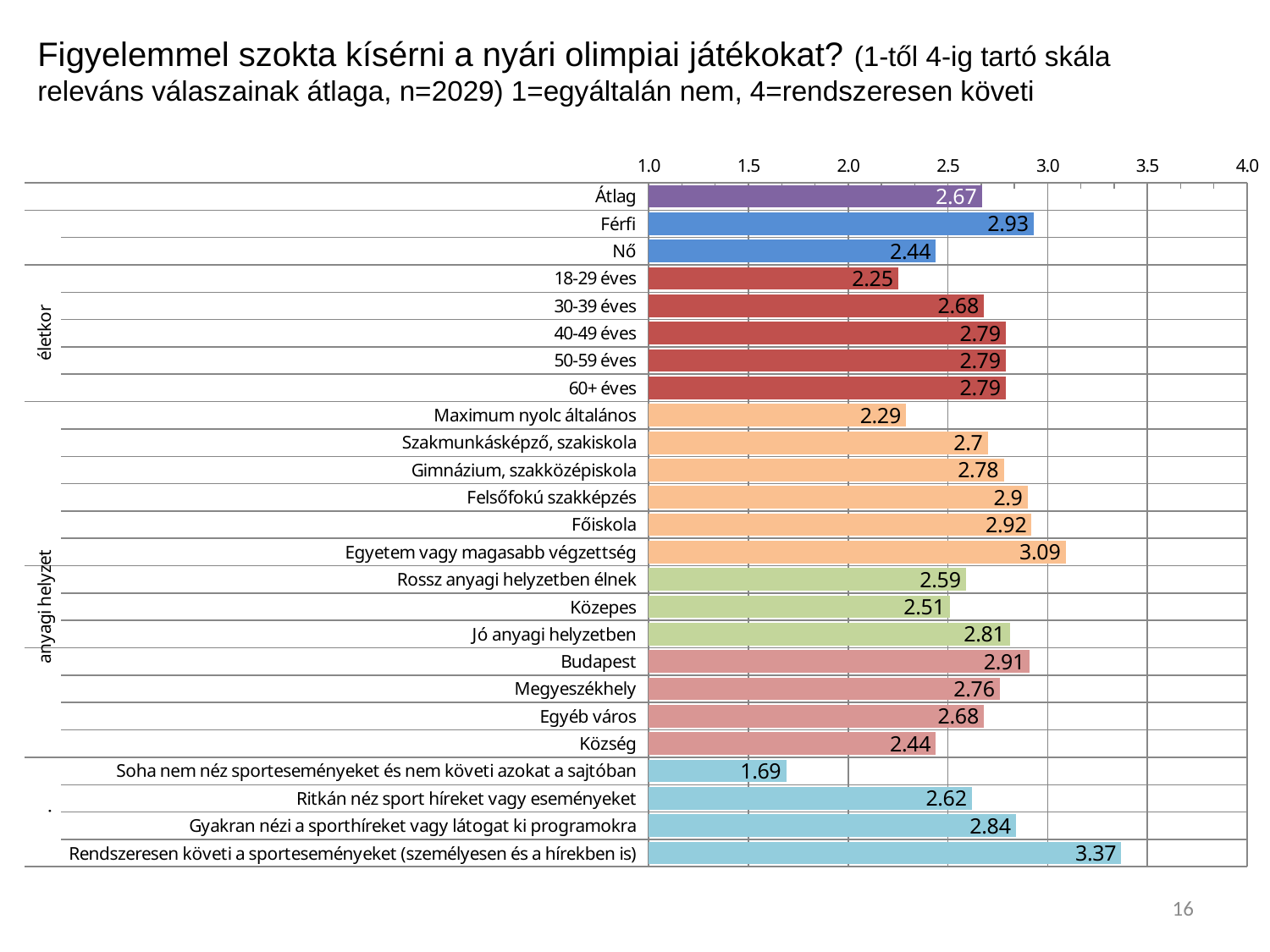
Is the value for 18-29 éves greater or less than 2.5? less How many categories (bars) are shown in the chart? 25 What is the maximum value shown on the horizontal axis? 4.0 Which has a larger value, Budapest or Község? Budapest Which category has the highest value? Rendszeresen követi a sporteseményeket (személyesen és a hírekben is) What is the difference between the values for Férfi and Nő? 0.49 What kind of chart is shown on the slide? bar chart Which category has the lowest value? Soha nem néz sporteseményeket és nem követi azokat a sajtóban What is the value for Átlag? 2.67 What is the value for Egyetem vagy magasabb végzettség? 3.09 What is the value for Férfi? 2.93 What is the value for Budapest? 2.91